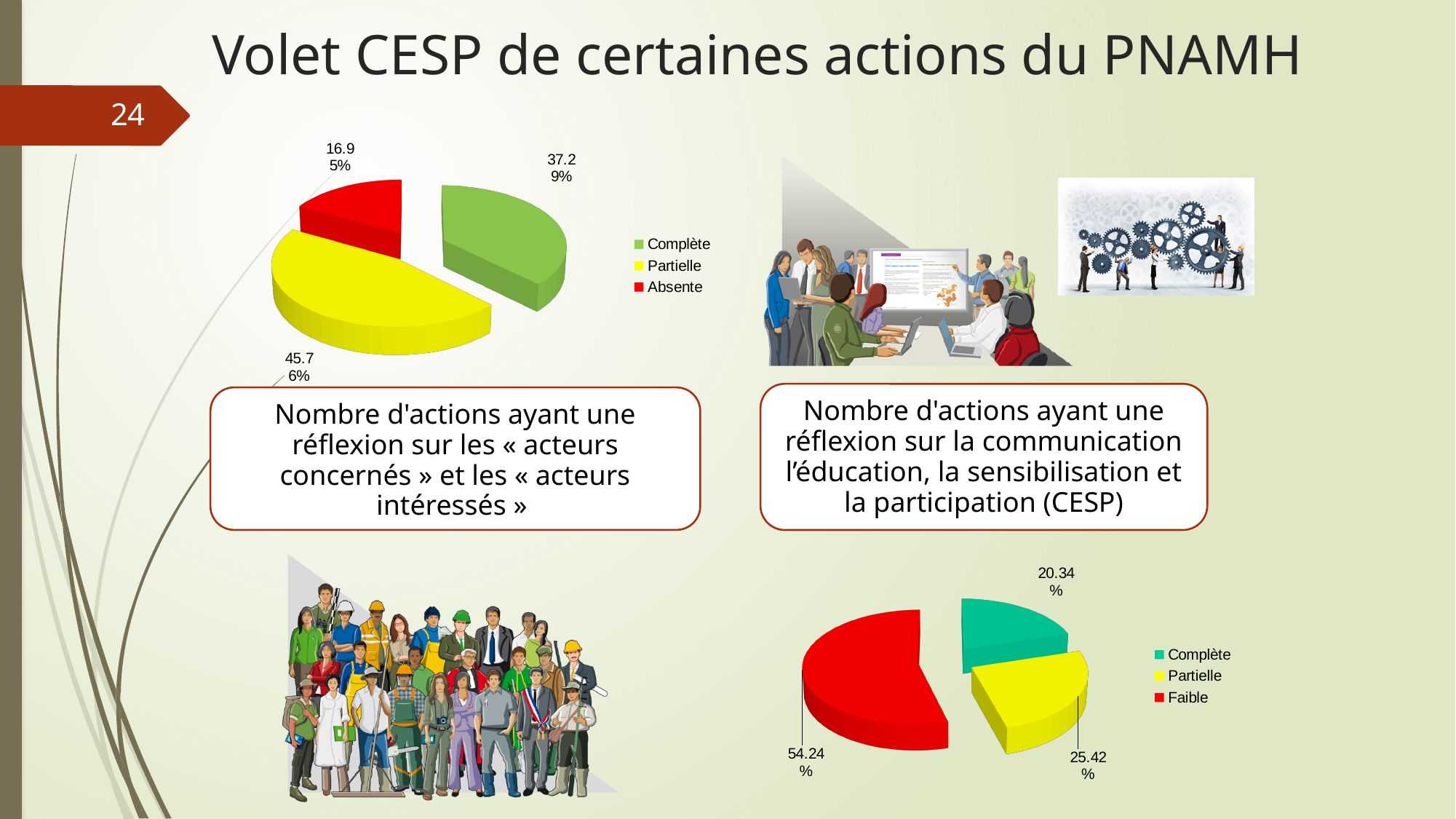
In the top-left pie chart, which category has the smallest share? Absente In the bottom-right pie chart, what percentage is shown for the Complète slice? 20.34% In the bottom-right pie chart, what percentage is shown for the Faible slice? 54.24% In the bottom-right pie chart, which is larger, Partielle or Complète? Partielle What type of chart is the bottom-right chart? Pie chart In the top-left pie chart, how many slices are there? 3 In the bottom-right pie chart, which category has the largest share? Faible In the bottom-right pie chart, what is the difference in percentage points between Faible and Partielle? 28.82 In the top-left pie chart, what percentage is shown for the Absente slice? 16.95% In the top-left pie chart, what percentage is shown for the Complète slice? 37.29% In the top-left pie chart, which category has the largest share? Partielle In the top-left pie chart, what percentage is shown for the Partielle slice? 45.76%